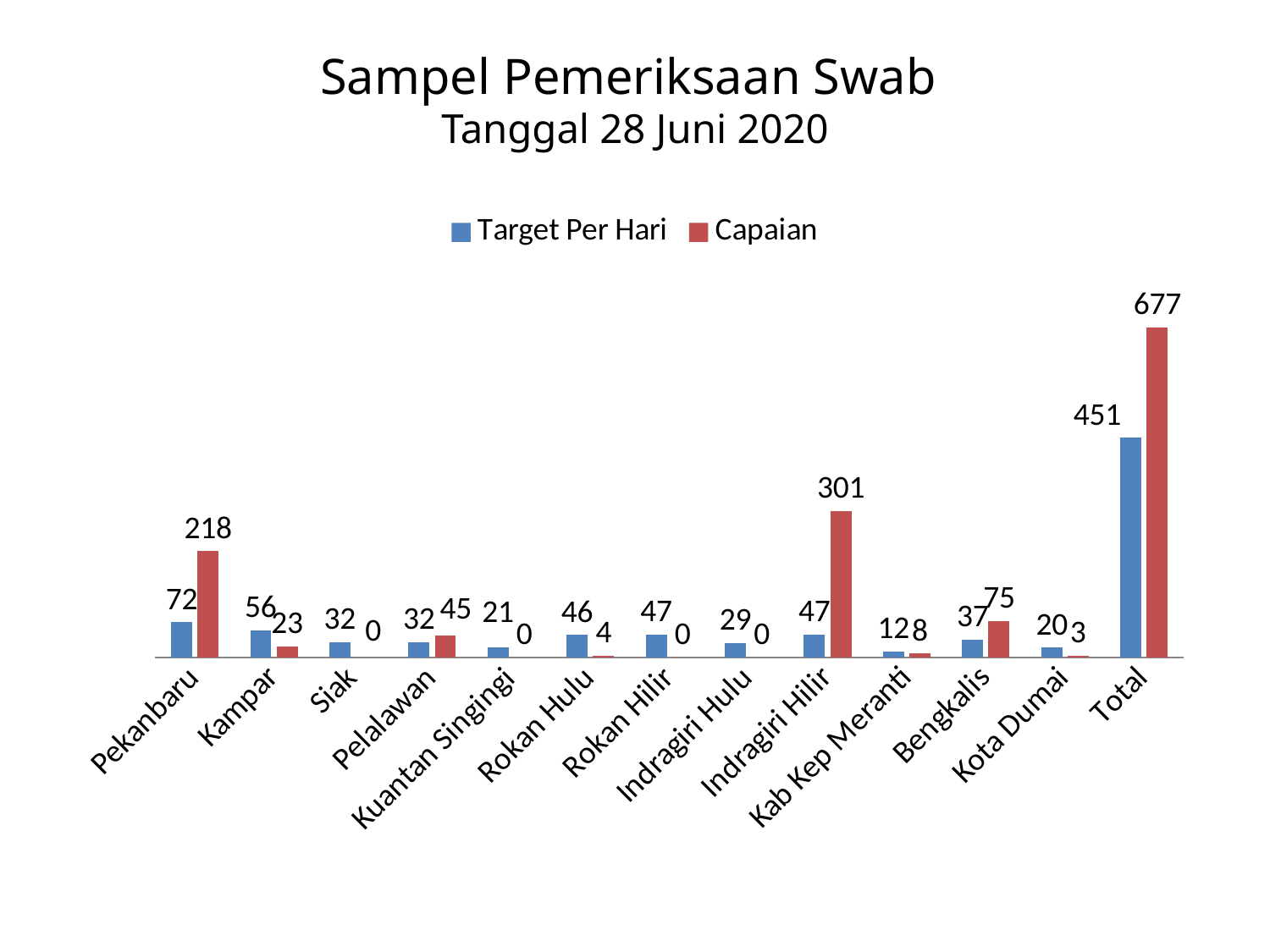
What is the difference between the Capaian and Target Per Hari values for Bengkalis? 38 Which is larger for Kampar, Target Per Hari or Capaian? Target Per Hari What kind of chart is shown on the slide? Bar chart What is the Target Per Hari value for Kuantan Singingi? 21 Which category has the lowest Target Per Hari value? Kab Kep Meranti How many series does the legend list? 2 What is the difference between the Capaian and Target Per Hari values for Total? 226 What is the Capaian value for Pekanbaru? 218 What is the Target Per Hari value for Indragiri Hilir? 47 Excluding the Total bar, which category has the highest Capaian value? Indragiri Hilir How many categories are shown on the x axis? 13 What is the Capaian value for Total? 677